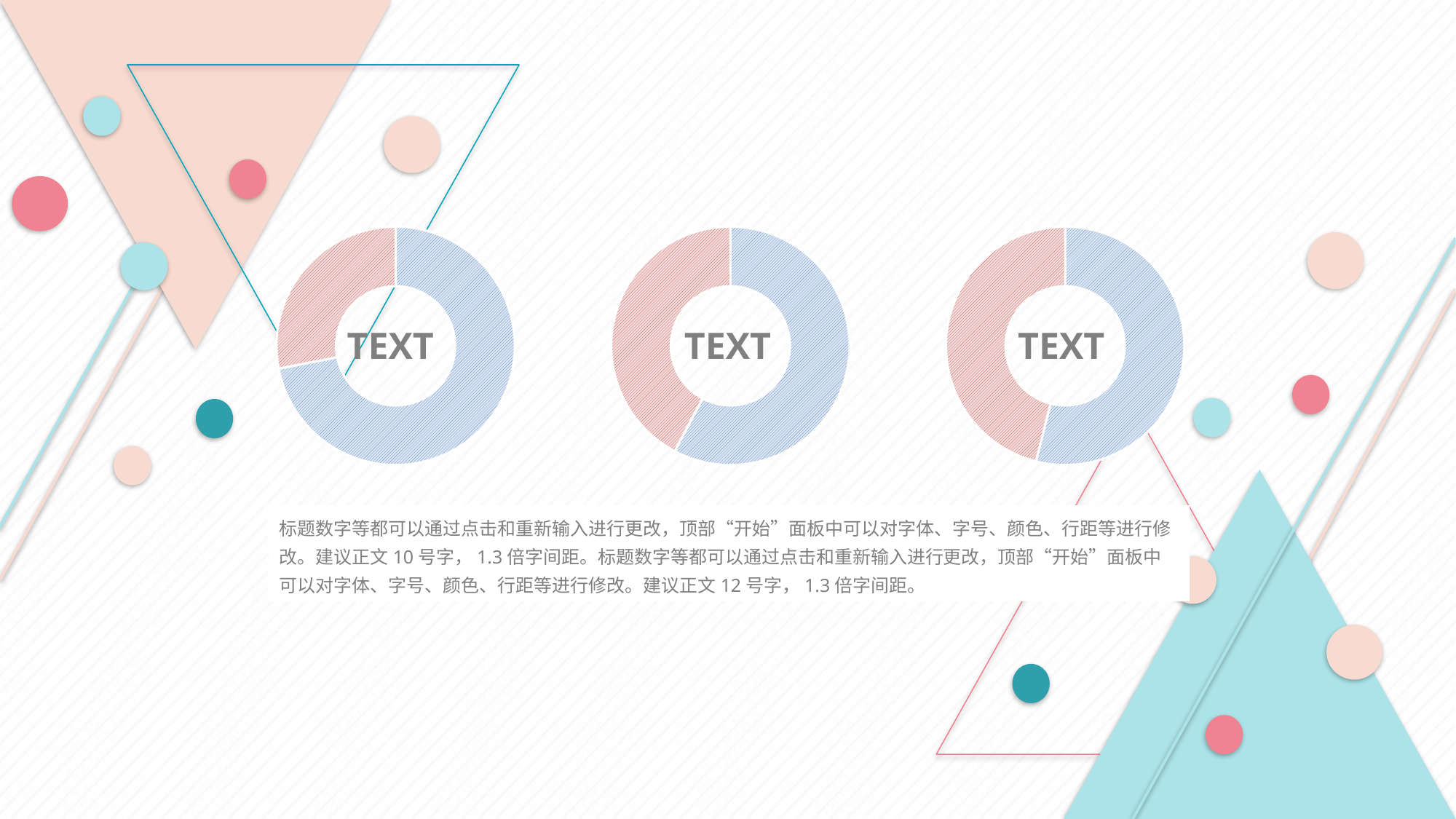
In the left chart, how many slices does the ring contain? 2 How many charts are shown on the slide? 3 In the middle chart, how many slices does the ring contain? 2 In the right chart, which slice is larger, the pink one or the blue one? blue What kind of chart is the left chart on the slide? doughnut chart In the middle chart, which slice is larger, the pink one or the blue one? blue What word is printed in the centre of each doughnut chart? TEXT Does the left chart display a legend? No What kind of chart is the right chart on the slide? doughnut chart In the left chart, which slice is larger, the pink one or the blue one? blue What kind of chart is the middle chart on the slide? doughnut chart